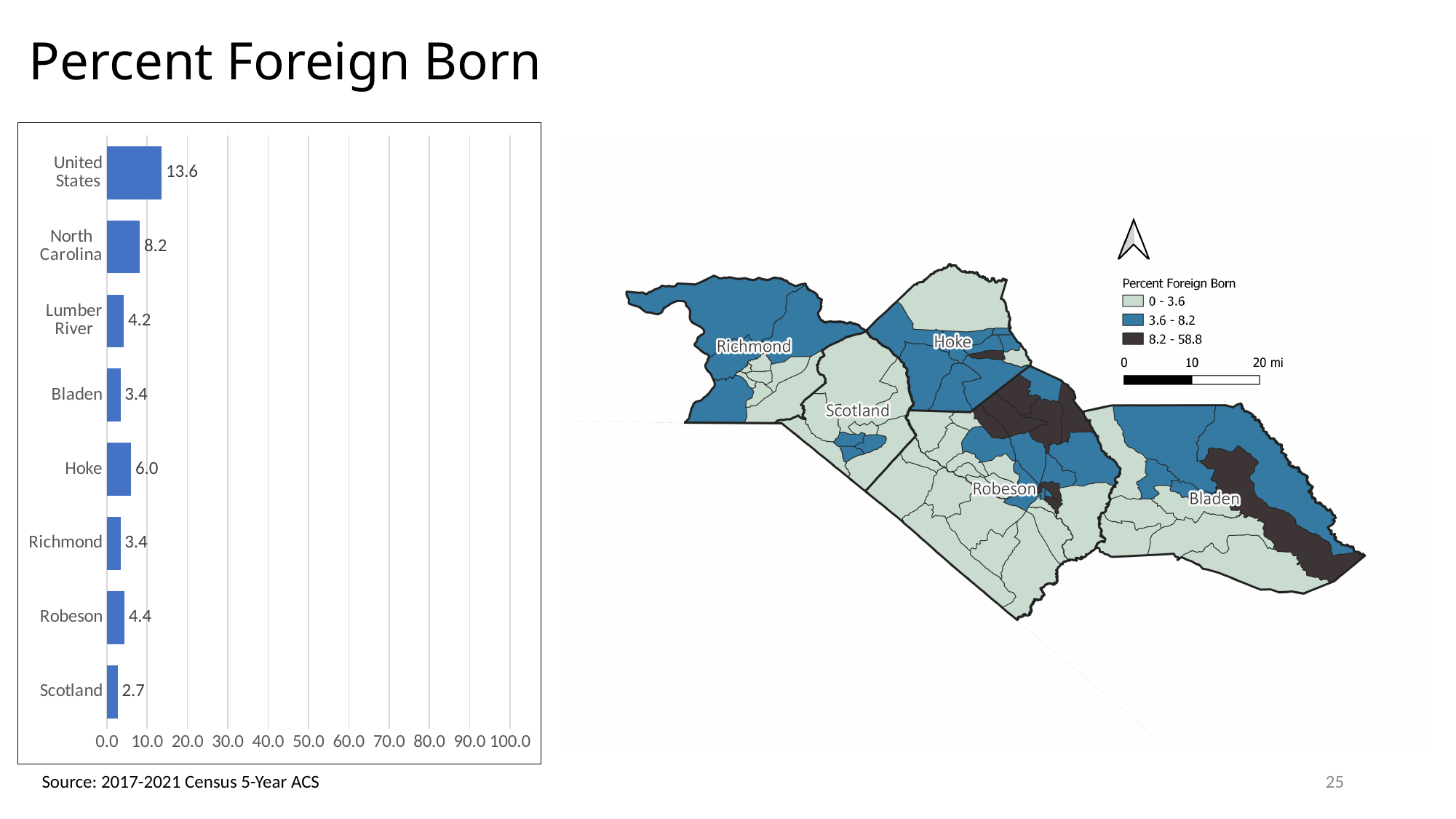
What is the percent foreign born value for North Carolina? 8.2 What is the percent foreign born value for Hoke? 6.0 What is the percent foreign born value for the United States? 13.6 What kind of chart is shown on the left of the slide? bar chart What is the difference between the United States and North Carolina values? 5.4 Which is larger, the value for Lumber River or the value for Bladen? Lumber River How many categories are shown in the bar chart? 8 Is the value for the United States greater or less than 10.0? greater Which category has the highest percent foreign born? United States What is the percent foreign born value for Scotland? 2.7 What is the difference between the Hoke and Robeson values? 1.6 Which category has the lowest percent foreign born? Scotland